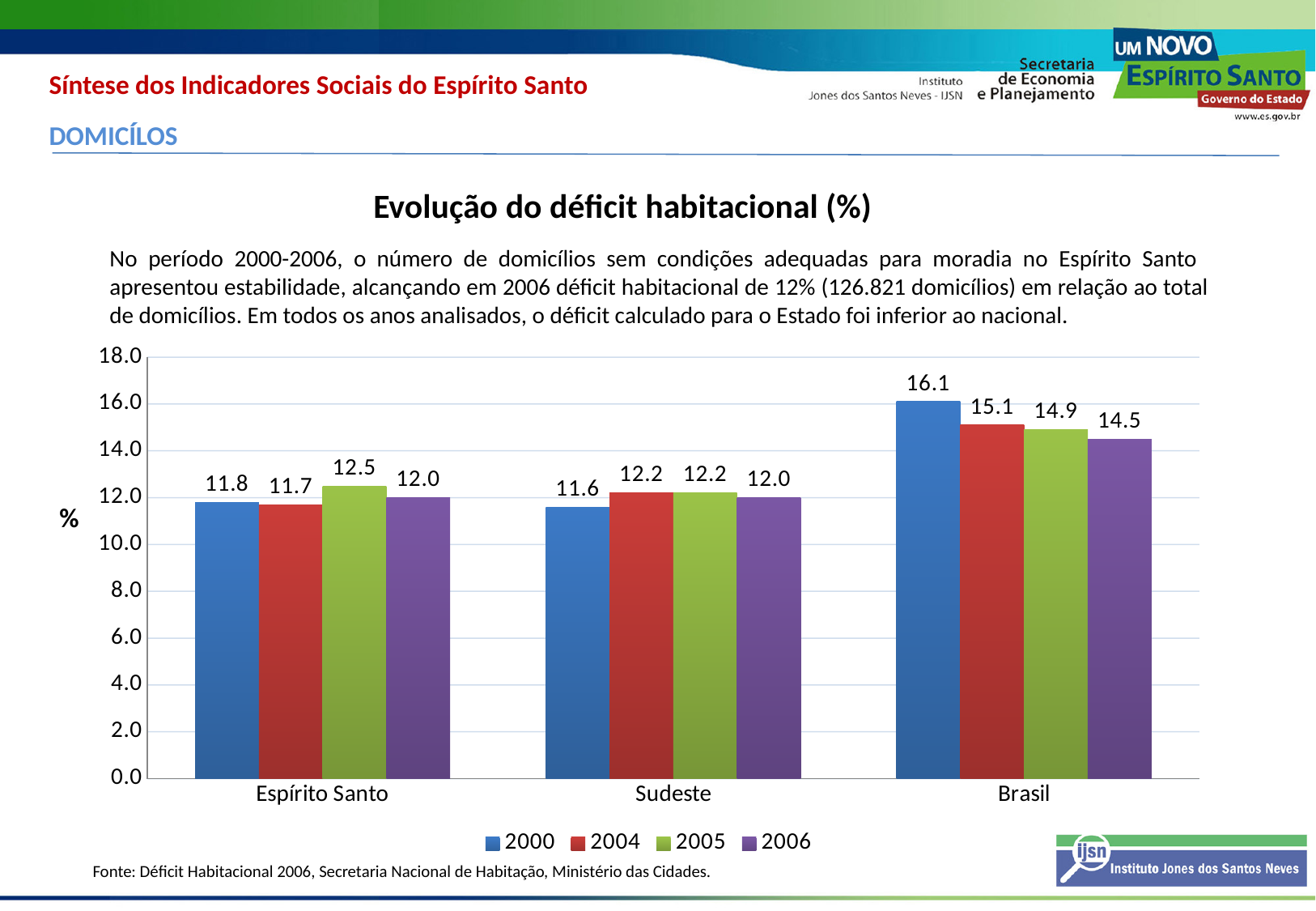
What is the value for Brasil in 2000? 16.1 Which is larger: the 2005 value for Espírito Santo or the 2005 value for Sudeste? Espírito Santo What is the title of the chart? Evolução do déficit habitacional (%) Which category has the highest value in the 2006 series? Brasil Is the value for Brasil in 2004 greater or less than 14.0? greater What is the value for Sudeste in 2004? 12.2 What kind of chart is shown on the slide? bar chart Which category has the lowest value in the 2000 series? Sudeste What is the value for Espírito Santo in 2005? 12.5 How many series does the legend list? 4 How many categories are shown on the x axis? 3 What is the difference between the 2000 and 2006 values for Brasil? 1.6